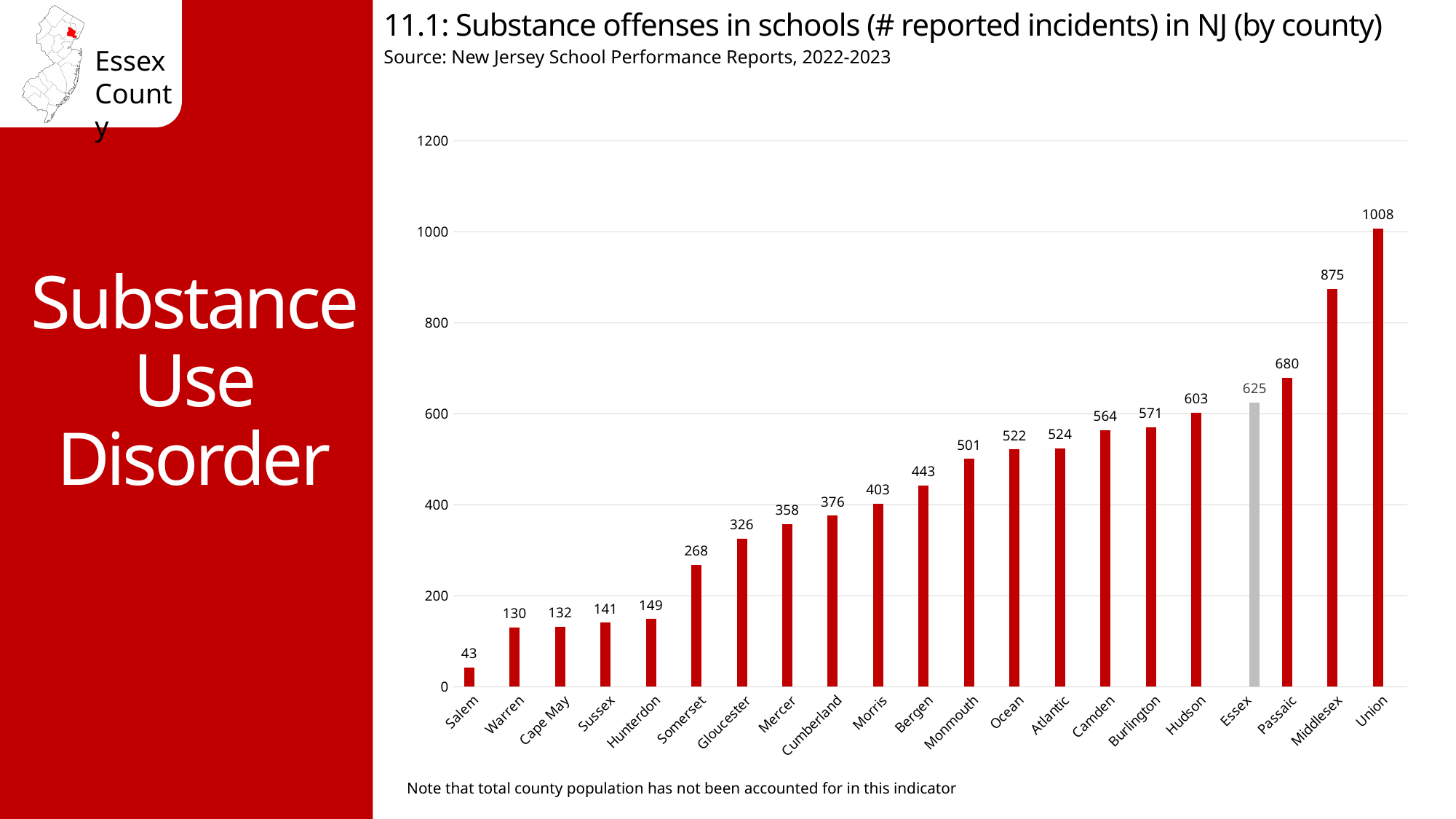
What is the difference between the values for Union and Middlesex? 133 What kind of chart is shown on the slide? Bar chart Which bar is shown in a different colour (grey) from the others? Essex Which county has more reported incidents, Hudson or Passaic? Passaic Which county has the highest number of reported incidents? Union What is the value shown for Monmouth County? 501 What is the value shown for Middlesex County? 875 Is the value for Bergen greater or less than 400? greater What is the number of reported substance offense incidents in schools for Essex County? 625 Which county has the lowest number of reported incidents? Salem How many counties are shown on the chart? 21 Do the values rise or fall moving from left to right along the x axis? Rise